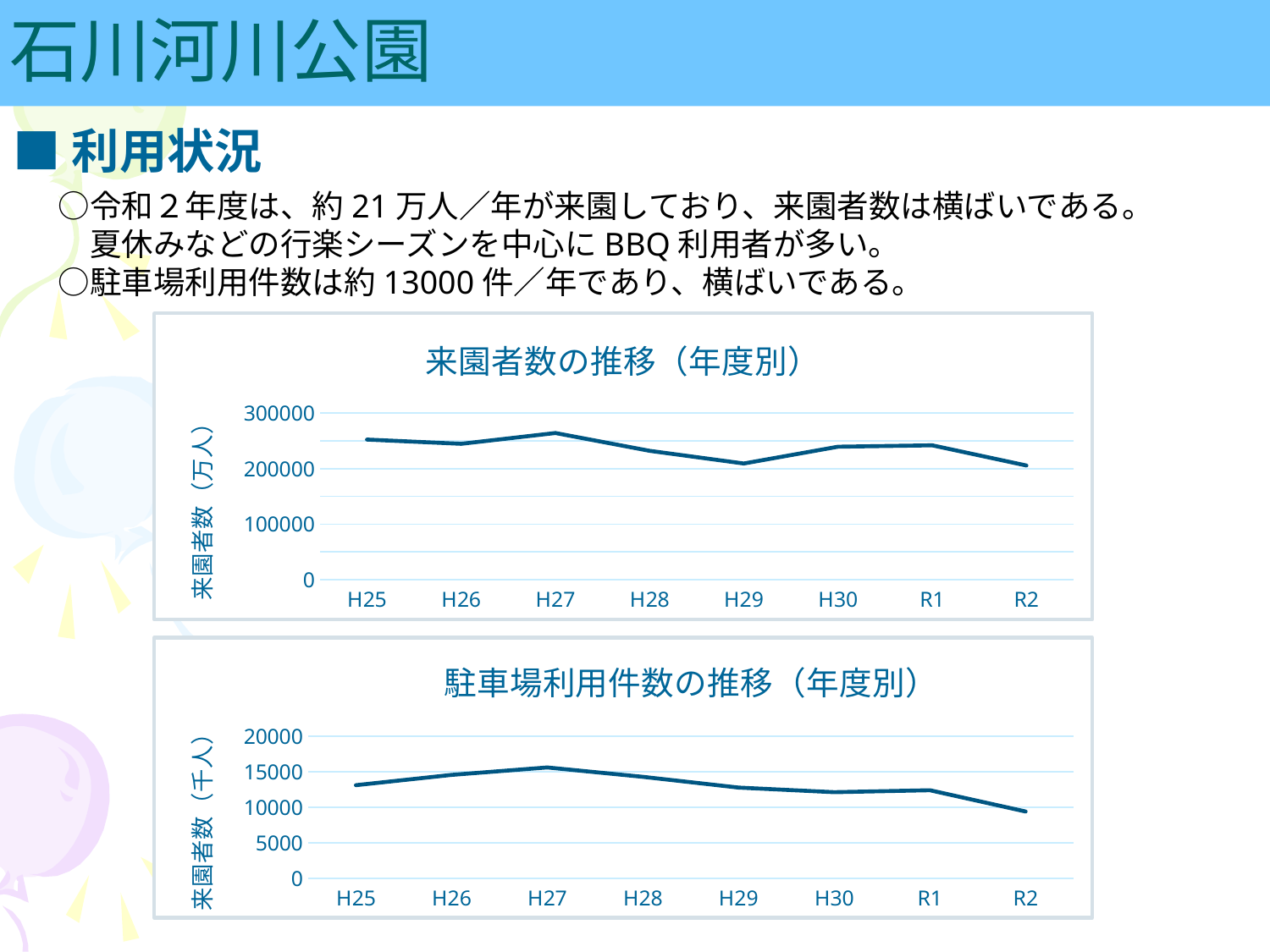
In the chart titled 来園者数の推移（年度別）, is the value for H27 greater or less than 200000? greater In the chart titled 来園者数の推移（年度別）, which year has the highest value? H27 In the chart titled 来園者数の推移（年度別）, which is larger, the value for H27 or the value for H29? H27 In the chart titled 駐車場利用件数の推移（年度別）, which is larger, the value for H25 or the value for R2? H25 In the chart titled 駐車場利用件数の推移（年度別）, which year has the lowest value? R2 In the chart titled 駐車場利用件数の推移（年度別）, is the value for R2 greater or less than 15000? less What is the title of the lower chart on the slide? 駐車場利用件数の推移（年度別） In the chart titled 来園者数の推移（年度別）, is the value for R2 greater or less than 300000? less In the chart titled 駐車場利用件数の推移（年度別）, does the value rise or fall from R1 to R2? fall In the chart titled 駐車場利用件数の推移（年度別）, which year has the highest value? H27 In the chart titled 来園者数の推移（年度別）, how many years are plotted on the x axis? 8 What kind of chart is the chart titled 来園者数の推移（年度別）? line chart